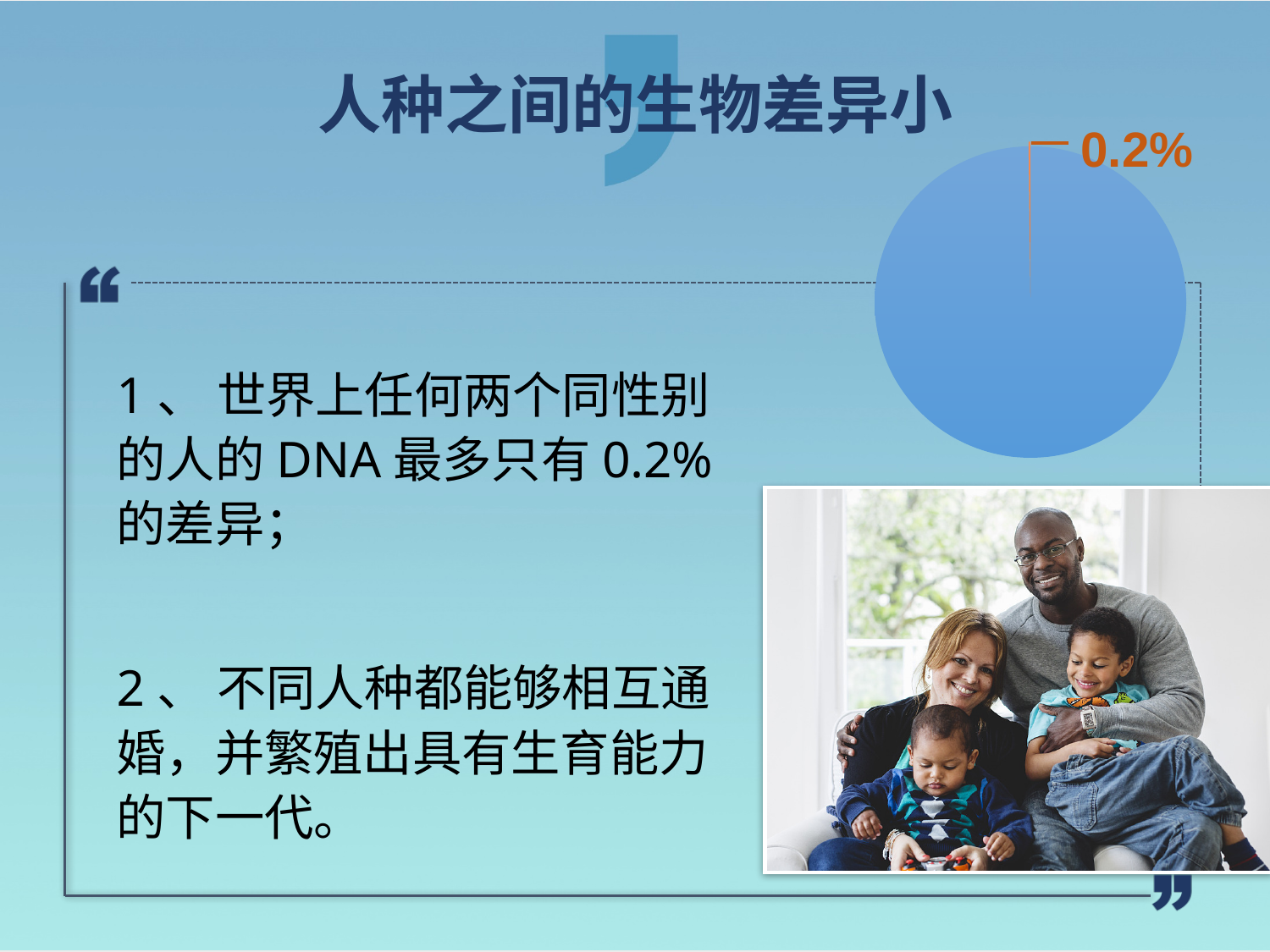
What value is printed as the data label on the pie chart? 0.2% What kind of chart is shown on the slide? pie chart How many slices does the pie chart contain? 2 What colour is the 0.2% data label on the pie chart? orange What share of the pie does the labelled slice represent? 0.2% What colour is the large slice of the pie chart? blue Is the labelled slice of the pie chart the largest or the smallest slice? smallest Is the value of the labelled slice greater or less than 1%? less